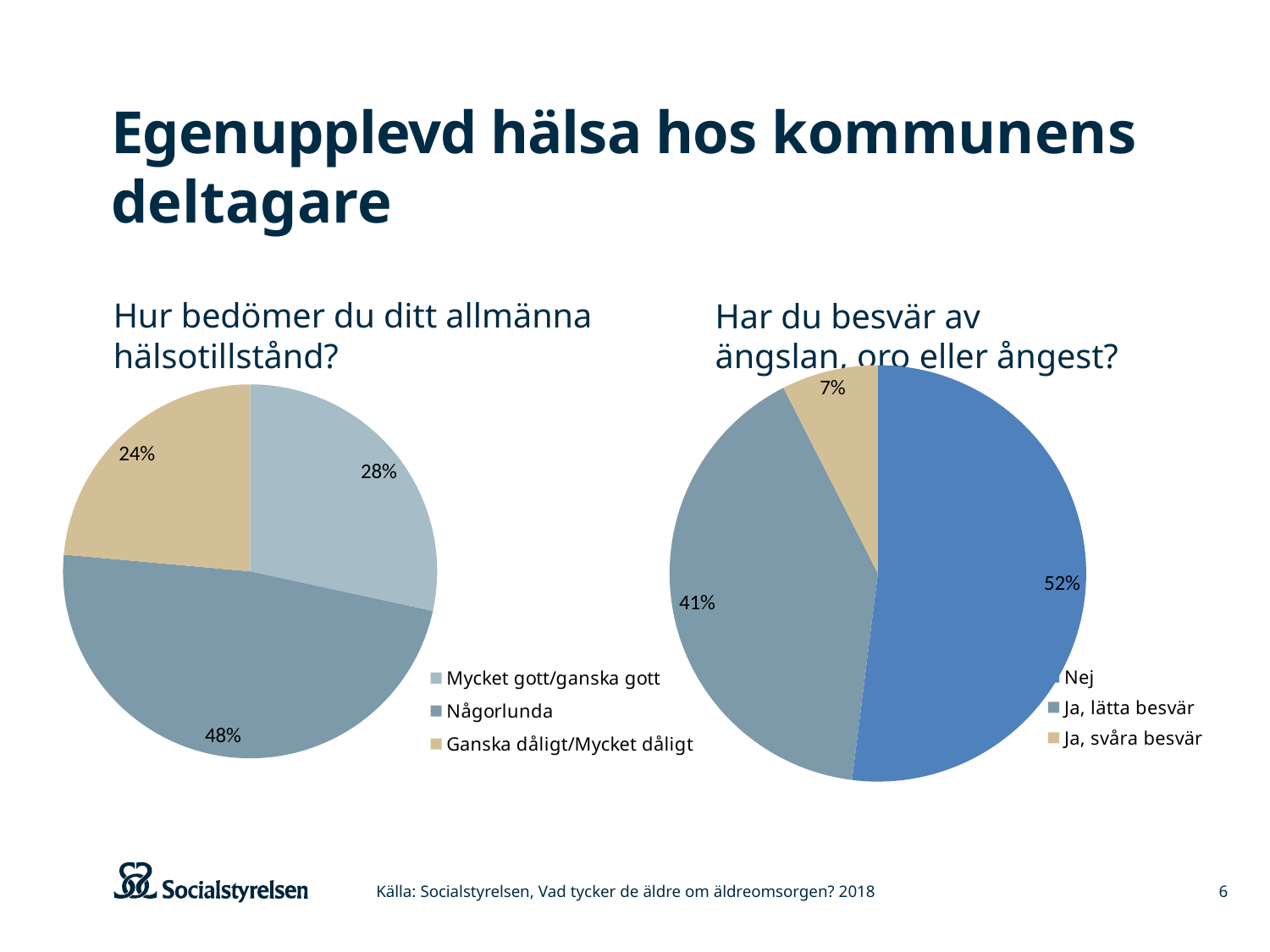
In the left chart (Hur bedömer du ditt allmänna hälsotillstånd?), what is the difference in percentage points between Någorlunda and Mycket gott/ganska gott? 20 percentage points In the right chart (Har du besvär av ängslan, oro eller ångest?), what share is labelled for Ja, svåra besvär? 7% What kind of chart is used for both charts on the slide? Pie chart In the right chart (Har du besvär av ängslan, oro eller ångest?), what share is labelled for Ja, lätta besvär? 41% In the left chart (Hur bedömer du ditt allmänna hälsotillstånd?), which category has the largest slice? Någorlunda In the left chart (Hur bedömer du ditt allmänna hälsotillstånd?), what share is labelled for Ganska dåligt/Mycket dåligt? 24% In the left chart (Hur bedömer du ditt allmänna hälsotillstånd?), what share is labelled for Någorlunda? 48% In the right chart (Har du besvär av ängslan, oro eller ångest?), what share is labelled for Nej? 52% In the left chart (Hur bedömer du ditt allmänna hälsotillstånd?), what share is labelled for Mycket gott/ganska gott? 28% In the right chart (Har du besvär av ängslan, oro eller ångest?), which is larger: Nej or Ja, lätta besvär? Nej In the right chart (Har du besvär av ängslan, oro eller ångest?), which category has the smallest slice? Ja, svåra besvär In the left chart (Hur bedömer du ditt allmänna hälsotillstånd?), which category has the smallest slice? Ganska dåligt/Mycket dåligt